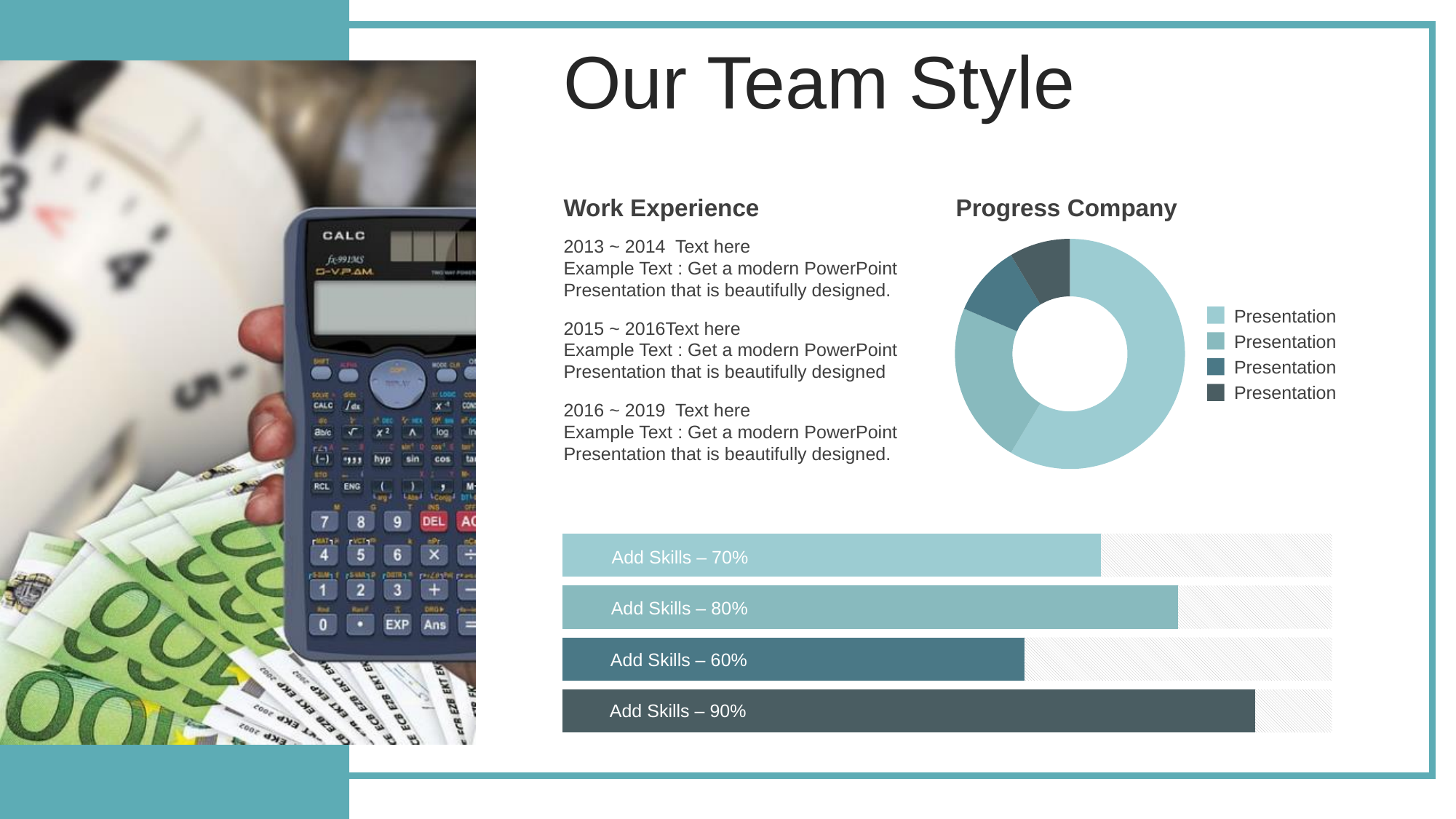
In the skills bar chart at the bottom of the slide, which bar has the lowest value? The third bar, 60% How many entries does the legend of the 'Progress Company' chart list? 4 In the skills bar chart at the bottom of the slide, which is larger: the second bar or the first bar? The second bar (80%) In the 'Progress Company' chart, what label is used for every legend entry? Presentation In the 'Progress Company' chart, which slice is the largest: the lightest blue one or the darkest one? The lightest blue one In the skills bar chart at the bottom of the slide, what value is shown on the third bar? 60% In the skills bar chart at the bottom of the slide, which bar has the highest value? The fourth (bottom) bar, 90% In the skills bar chart at the bottom of the slide, what value is shown on the first (top) bar? 70% In the skills bar chart at the bottom of the slide, what is the difference between the highest and lowest bar values? 30% What kind of chart is the 'Progress Company' chart? Doughnut chart What kind of chart is the skills chart at the bottom of the slide? Bar chart How many bars are in the skills bar chart at the bottom of the slide? 4